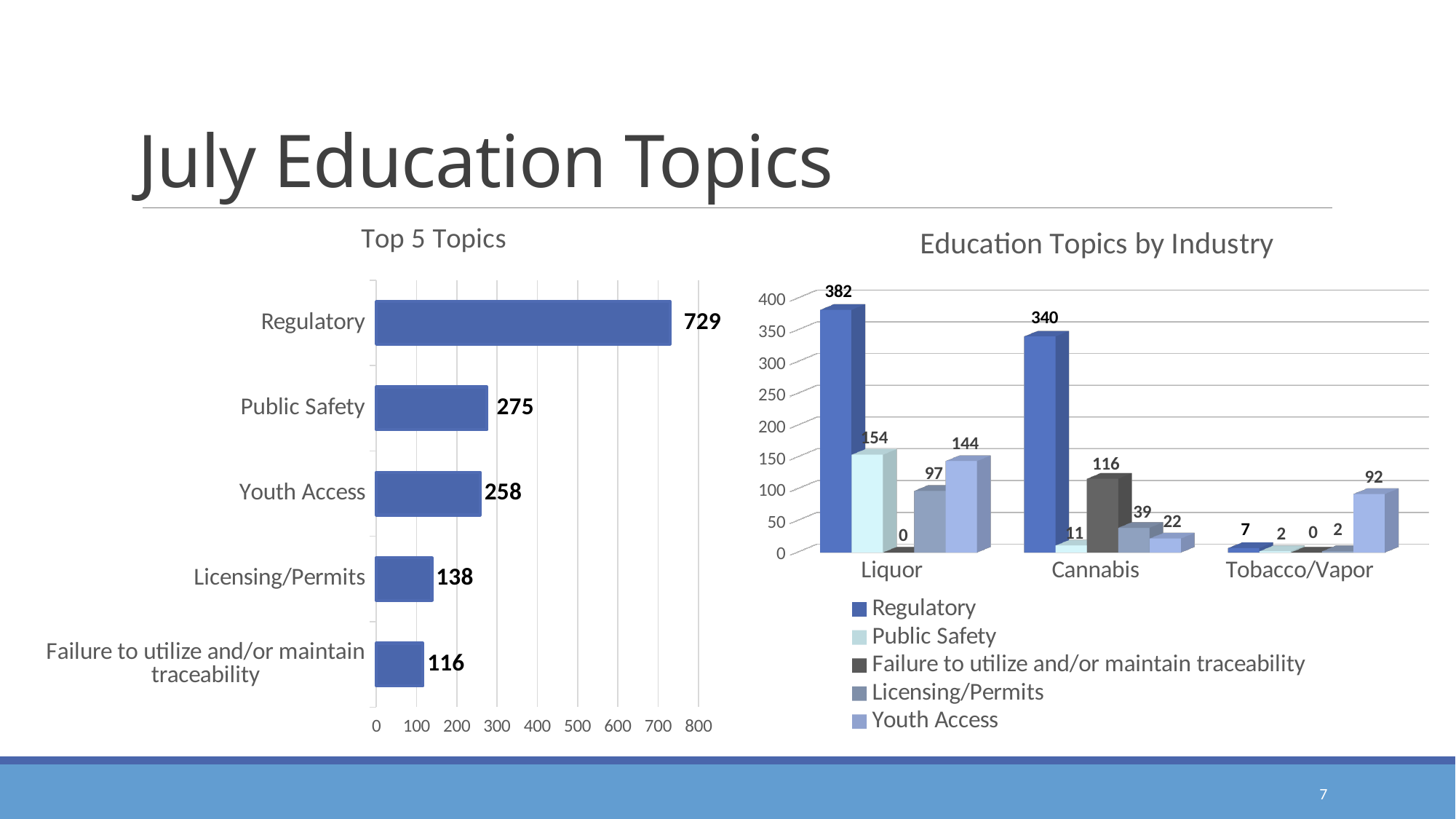
In the Top 5 Topics chart, what is the value for Public Safety? 275 In the Education Topics by Industry chart, what is the difference between the Regulatory values for Liquor and Cannabis? 42 In the Top 5 Topics chart, which topic has the highest value? Regulatory What kind of chart is the Top 5 Topics chart? Bar chart In the Top 5 Topics chart, how many topics are shown? 5 In the Education Topics by Industry chart, which industry has the lowest Regulatory value? Tobacco/Vapor In the Education Topics by Industry chart, how many series does the legend list? 5 In the Education Topics by Industry chart, what is the Youth Access value for Tobacco/Vapor? 92 In the Education Topics by Industry chart, what is the Regulatory value for Cannabis? 340 In the Top 5 Topics chart, which topic has the lowest value? Failure to utilize and/or maintain traceability In the Top 5 Topics chart, what is the difference between Regulatory and Public Safety? 454 In the Education Topics by Industry chart, which is larger for Liquor: Public Safety or Youth Access? Public Safety